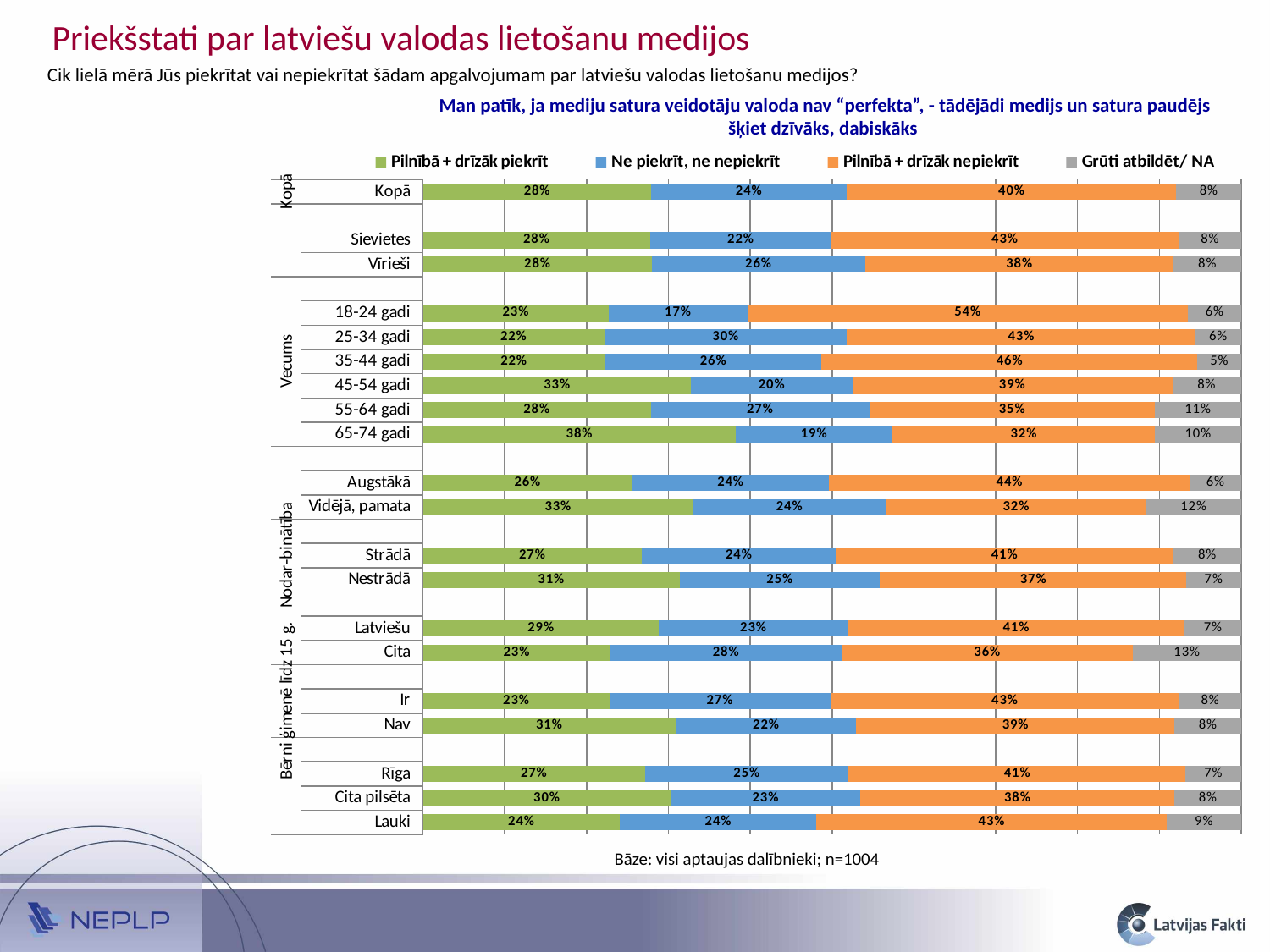
What type of chart is shown on the slide? Stacked bar chart What is the legend label of the orange series? Pilnībā + drīzāk nepiekrīt What is the total of the stacked bar for Sievietes? 101% What is the value of "Pilnībā + drīzāk piekrīt" for 65-74 gadi? 38% Which category has the lowest value for "Grūti atbildēt/ NA"? 35-44 gadi What is the value of "Ne piekrīt, ne nepiekrīt" for 25-34 gadi? 30% How many series does the legend list? 4 Which category has the highest value for "Pilnībā + drīzāk nepiekrīt"? 18-24 gadi What is the value of "Grūti atbildēt/ NA" for the Cita category? 13% What is the difference in "Pilnībā + drīzāk nepiekrīt" between 18-24 gadi and Kopā? 14 percentage points Which has a larger "Pilnībā + drīzāk piekrīt" value, Nestrādā or Strādā? Nestrādā What is the value of "Pilnībā + drīzāk nepiekrīt" for the Kopā category? 40%